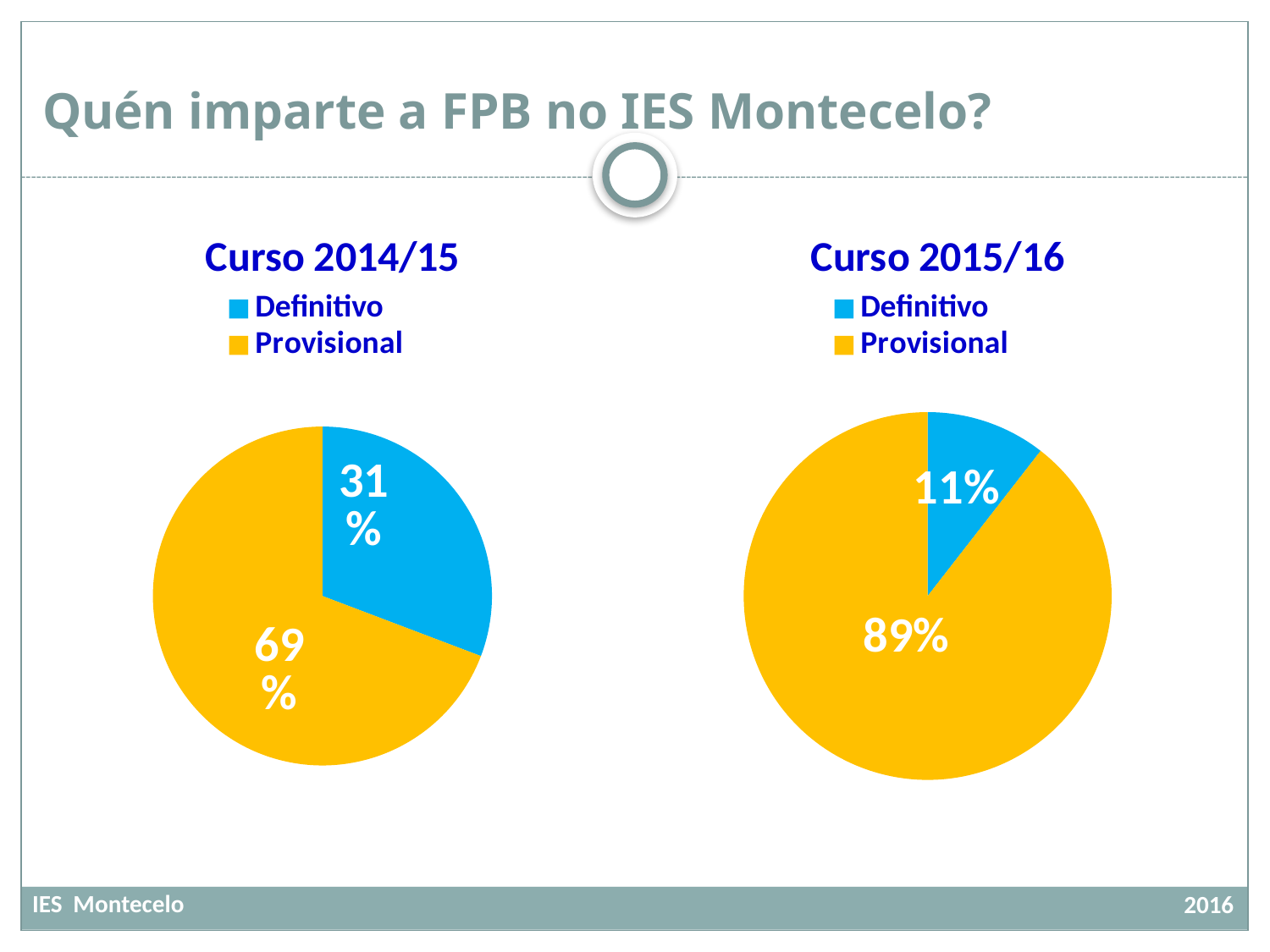
In the 'Curso 2014/15' chart, what share does Definitivo have? 31% In the 'Curso 2015/16' chart, what colour is the Provisional slice? Yellow In the 'Curso 2015/16' chart, what is the difference between the Provisional and Definitivo shares? 78% In the 'Curso 2015/16' chart, which category has the smallest slice? Definitivo In the 'Curso 2014/15' chart, what is the difference between the Provisional and Definitivo shares? 38% In the 'Curso 2014/15' chart, what share does Provisional have? 69% What kind of chart is the 'Curso 2015/16' chart? Pie chart In the 'Curso 2015/16' chart, what share does Definitivo have? 11% In the 'Curso 2015/16' chart, what share does Provisional have? 89% Is the Definitivo share larger in the 'Curso 2014/15' chart or the 'Curso 2015/16' chart? Curso 2014/15 How many categories does the 'Curso 2014/15' chart show? 2 In the 'Curso 2014/15' chart, which category has the largest slice? Provisional